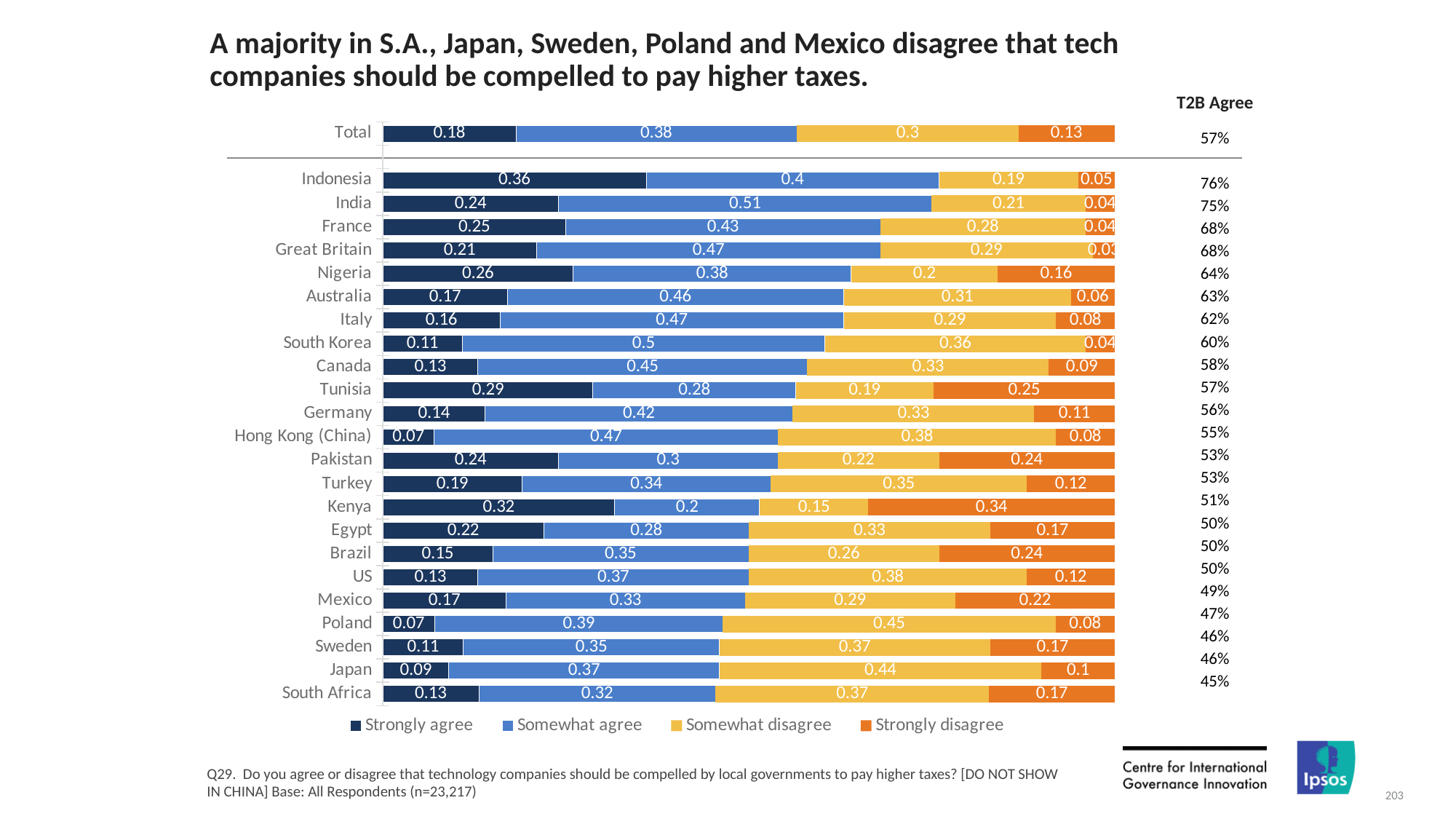
What is the difference between the Strongly agree value for Indonesia and the Strongly agree value for Total? 0.18 What kind of chart is shown on the slide? Stacked bar chart How many series does the legend list? 4 Which country has the highest Somewhat agree value? India Which country has the highest Strongly agree value? Indonesia What is the Somewhat agree value for the Total bar? 0.38 What is the Strongly agree value for Indonesia? 0.36 What is the Somewhat disagree value for Poland? 0.45 Which has the larger Strongly agree value, Tunisia or Nigeria? Tunisia How many countries (excluding Total) are plotted in the chart? 23 What is the Strongly disagree value for Kenya? 0.34 Which country has the highest Strongly disagree value? Kenya